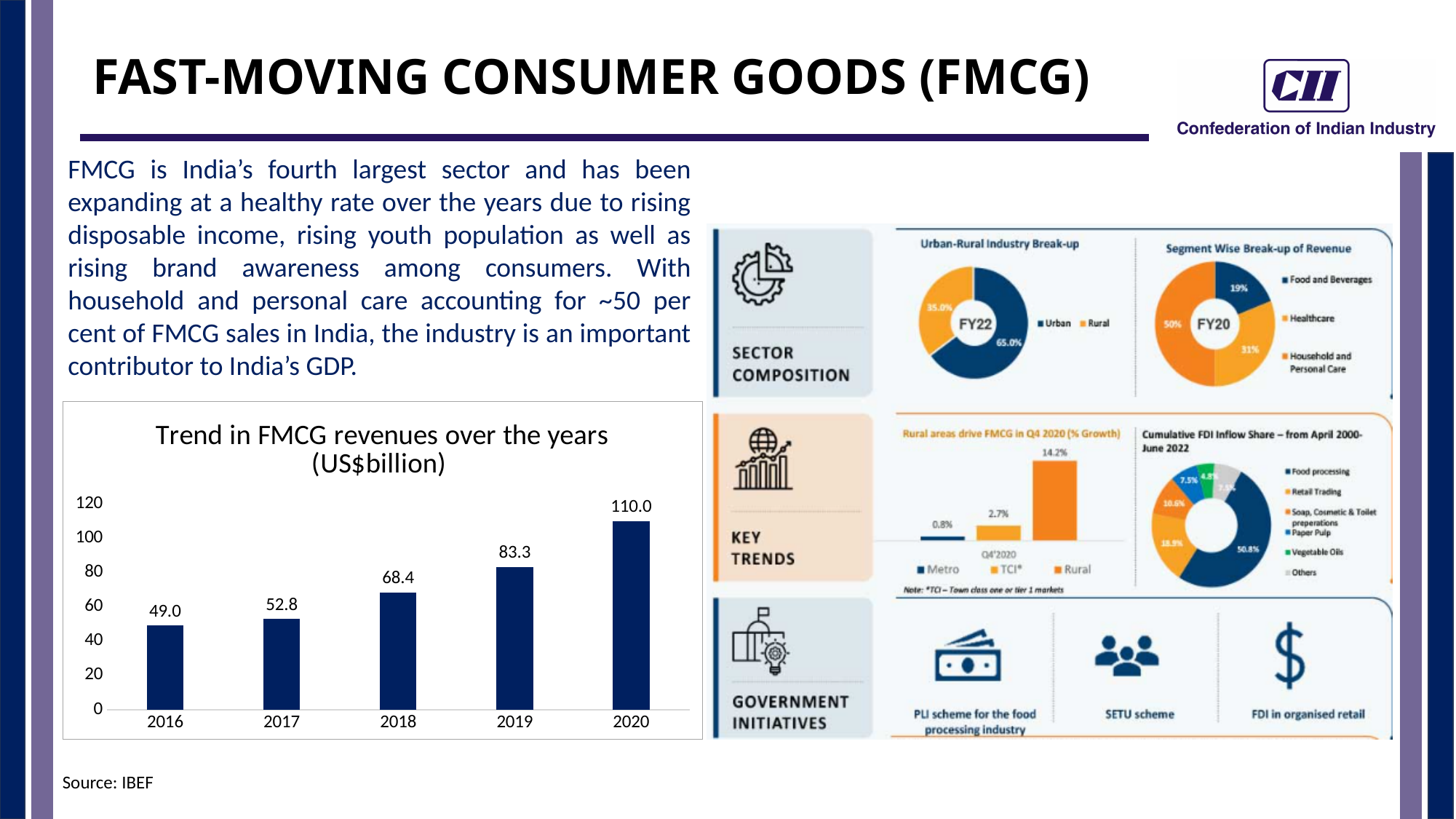
In the 'Trend in FMCG revenues over the years (US$billion)' chart, what is the value for 2018? 68.4 In the 'Rural areas drive FMCG in Q4 2020 (% Growth)' chart, what is the value for Rural? 14.2% In the 'Trend in FMCG revenues over the years (US$billion)' chart, what is the difference between the 2020 and 2019 values? 26.7 In the 'Trend in FMCG revenues over the years (US$billion)' chart, which year has the lowest value? 2016 What kind of chart is 'Trend in FMCG revenues over the years (US$billion)'? Bar chart In the 'Trend in FMCG revenues over the years (US$billion)' chart, do the values rise or fall from 2016 to 2020? Rise In the 'Trend in FMCG revenues over the years (US$billion)' chart, how many years are shown on the x axis? 5 In the 'Trend in FMCG revenues over the years (US$billion)' chart, which is larger, the value for 2017 or the value for 2018? 2018 In the 'Trend in FMCG revenues over the years (US$billion)' chart, what is the value for 2020? 110.0 In the 'Urban-Rural Industry Break-up' pie chart, what share is Urban? 65.0% In the 'Trend in FMCG revenues over the years (US$billion)' chart, which year has the highest value? 2020 In the 'Segment Wise Break-up of Revenue' pie chart, what share is Household and Personal Care? 50%